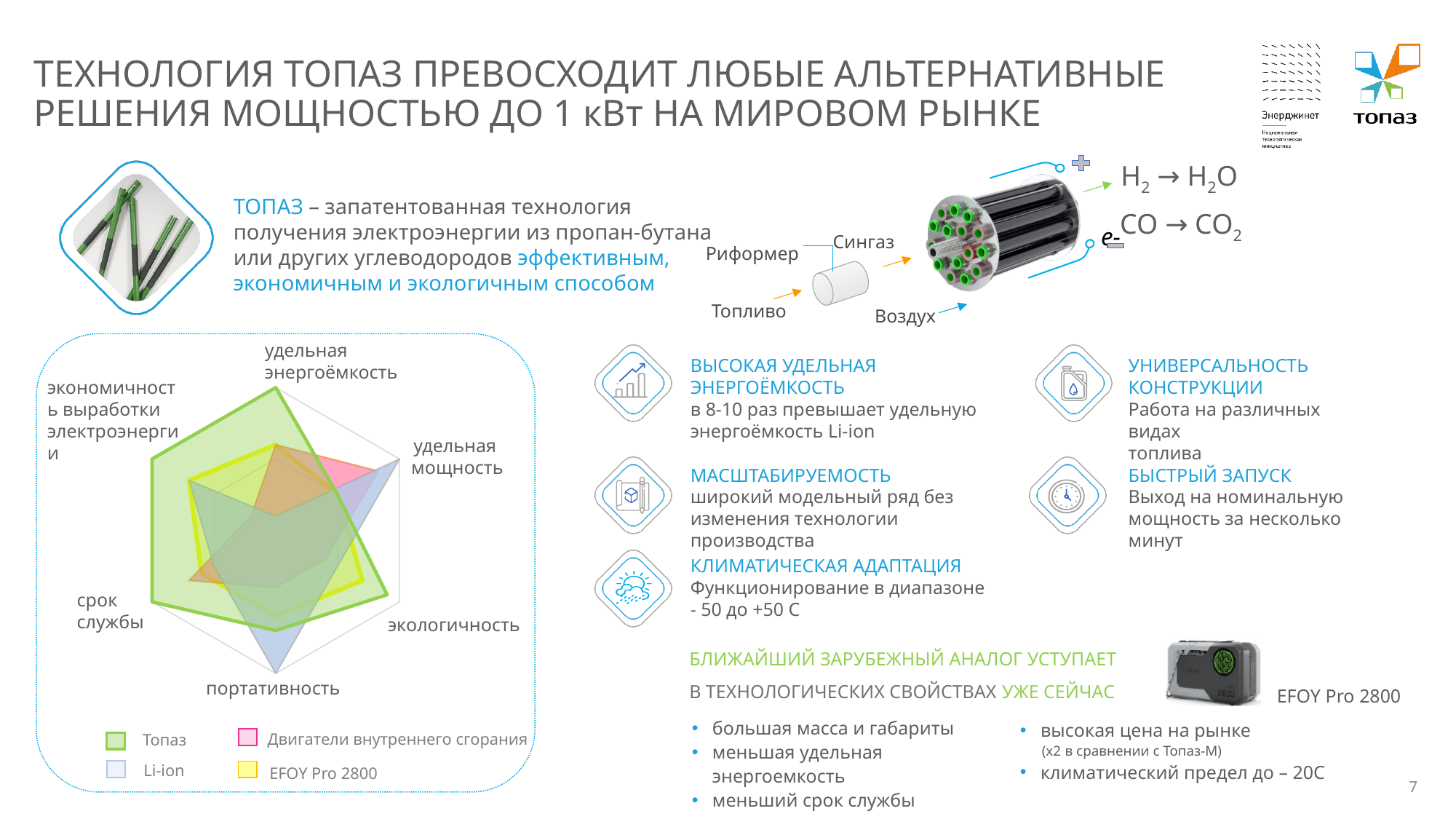
Which series has the highest value on the 'портативность' axis of the radar chart? Li-ion Which series has the highest value on the 'удельная энергоёмкость' axis of the radar chart? Топаз How many axes (criteria) does the radar chart have? 6 Which series in the radar chart is drawn in yellow? EFOY Pro 2800 On the 'портативность' axis of the radar chart, which is larger: Li-ion or Топаз? Li-ion On the 'удельная энергоёмкость' axis of the radar chart, which is larger: Топаз or Li-ion? Топаз Which series in the radar chart is drawn in green? Топаз Which axis label appears at the top of the radar chart? удельная энергоёмкость Which series has the highest value on the 'экономичность выработки электроэнергии' axis of the radar chart? Топаз What kind of chart is shown on the left of the slide? Radar chart How many series does the legend of the radar chart list? 4